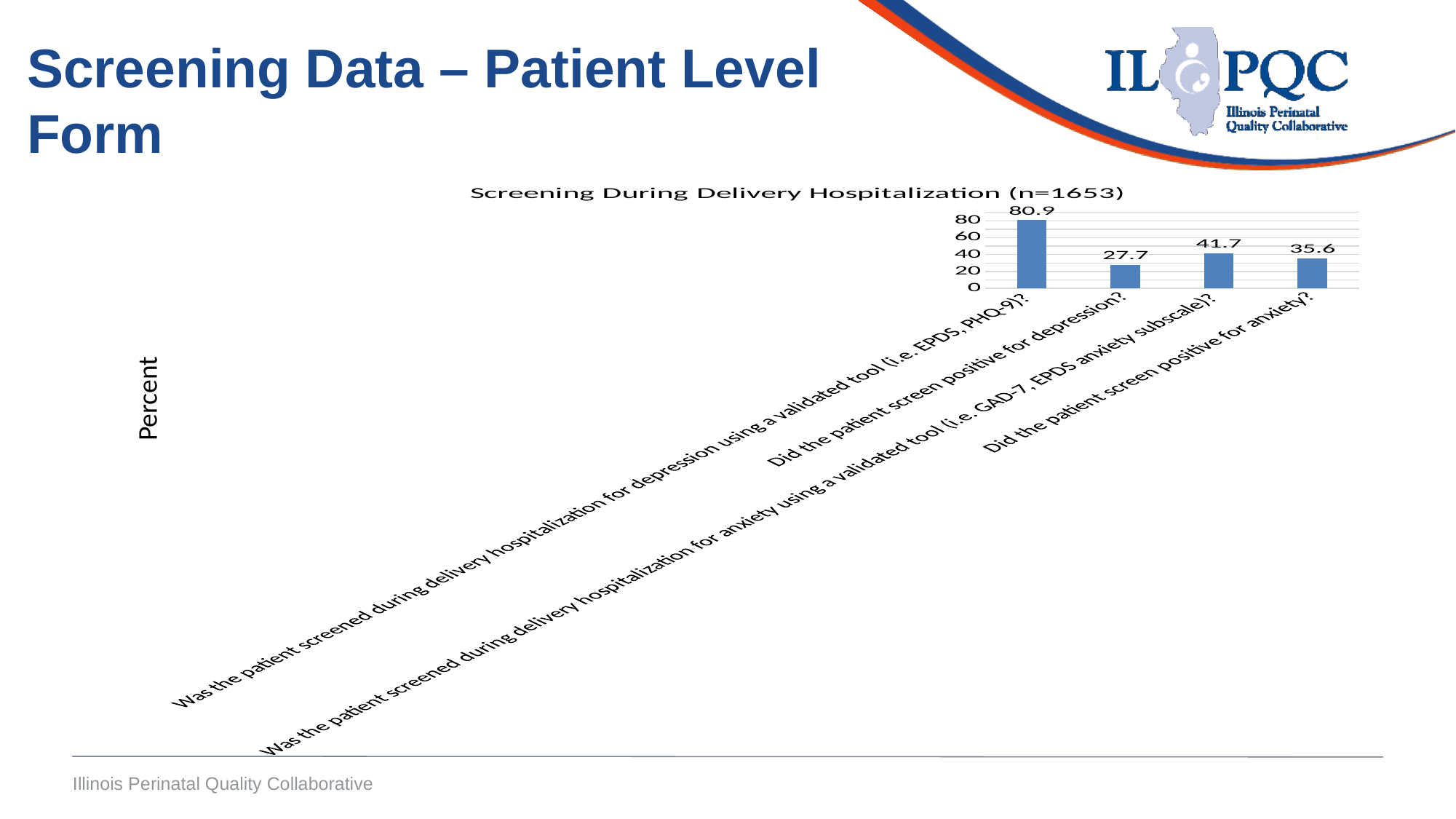
What kind of chart is shown on the slide? Bar chart What is the value for 'Did the patient screen positive for depression?' 27.7 What is the value for 'Was the patient screened during delivery hospitalization for depression using a validated tool (i.e. EPDS, PHQ-9)?' 80.9 What is the label of the vertical axis? Percent Which category has the lowest value? Did the patient screen positive for depression? What is the value for 'Was the patient screened during delivery hospitalization for anxiety using a validated tool (i.e. GAD-7, EPDS anxiety subscale)?' 41.7 What is the value for 'Did the patient screen positive for anxiety?' 35.6 How many categories are shown in the chart? 4 What is the difference between the value for screening for depression using a validated tool and the value for screening for anxiety using a validated tool? 39.2 Which category has the highest value? Was the patient screened during delivery hospitalization for depression using a validated tool (i.e. EPDS, PHQ-9)? Which is larger: the value for 'Did the patient screen positive for anxiety?' or the value for 'Did the patient screen positive for depression?' Did the patient screen positive for anxiety? What is the title of the chart? Screening During Delivery Hospitalization (n=1653)